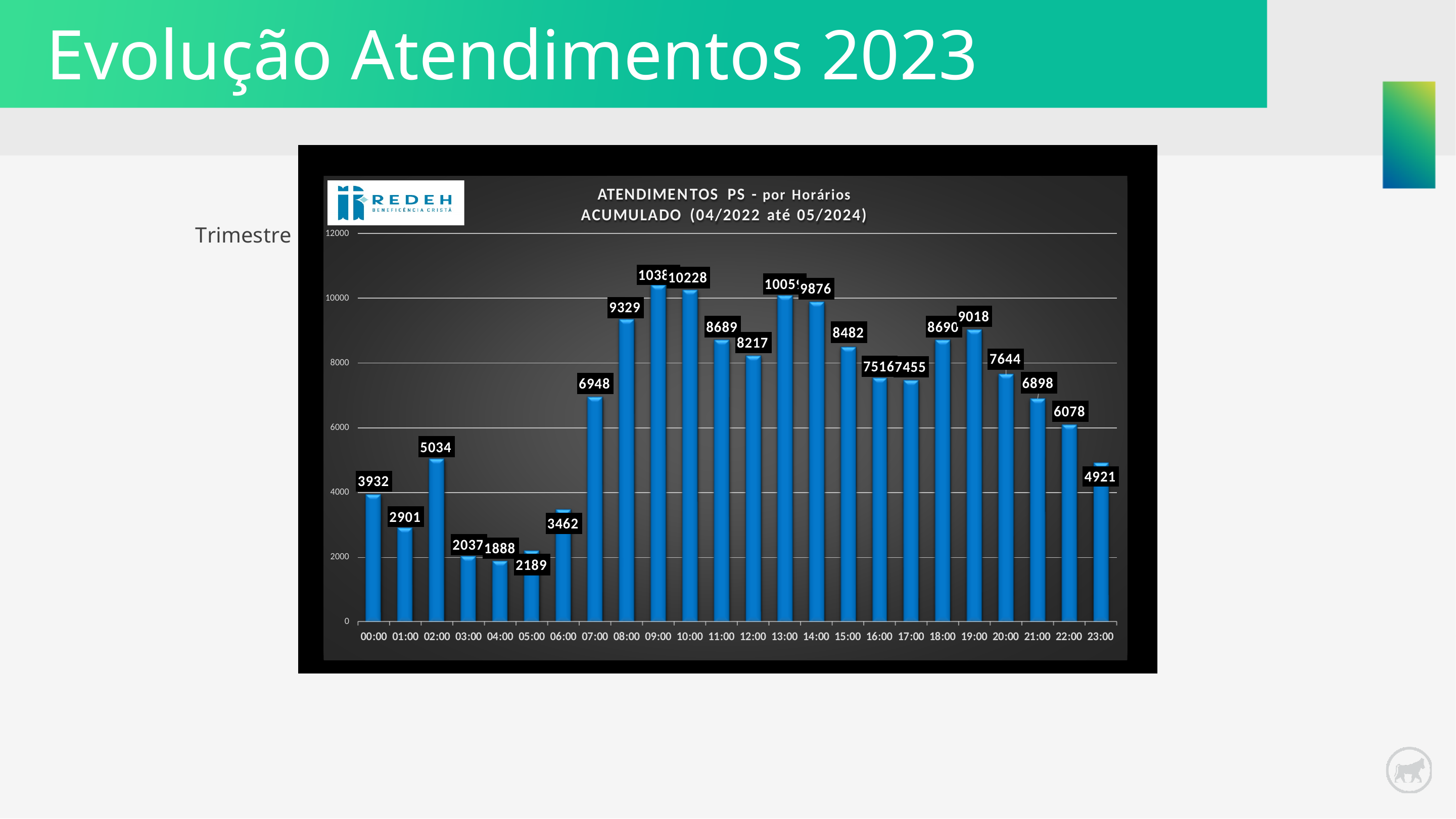
How many hourly categories are shown on the x axis? 24 What is the value for 19:00? 9018 What is the difference between the values for 10:00 and 08:00? 899 What kind of chart is shown on the slide? bar chart Is the value for 09:00 greater or less than 10000? greater Do the values rise or fall from 19:00 to 23:00? fall Which hour has the highest value? 09:00 What is the value for 10:00? 10228 What is the value for 23:00? 4921 Which is larger, the value for 02:00 or the value for 06:00? 02:00 What is the value for 00:00? 3932 Which hour has the lowest value? 04:00